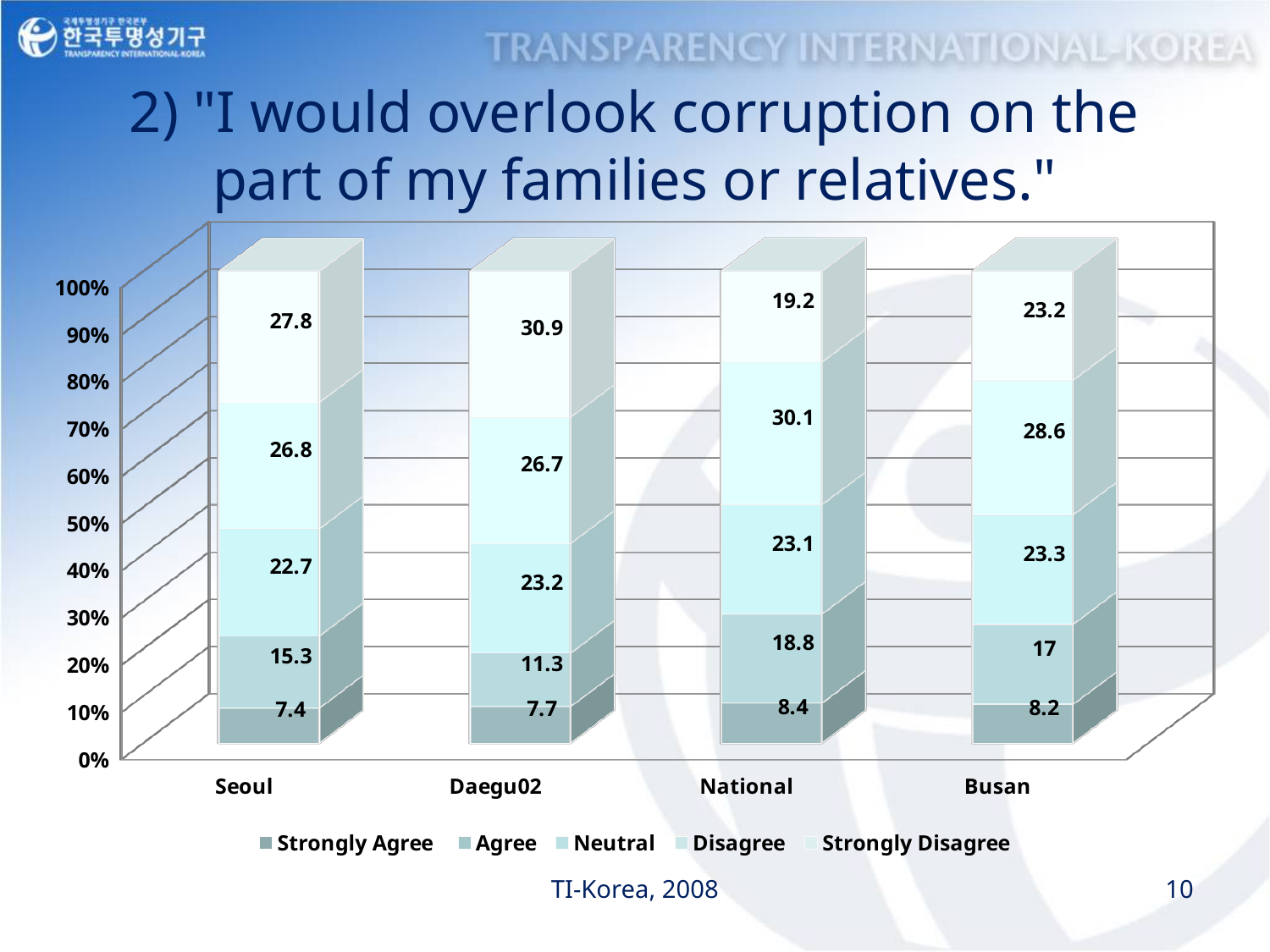
Which is larger, the Strongly Disagree value for Seoul or for Busan? Seoul What is the Agree value for National? 18.8 Which legend entry is listed first? Strongly Agree What is the Neutral value for Busan? 23.3 How many series does the legend list? 5 What is the Strongly Disagree value for Daegu02? 30.9 What is the Strongly Agree value for Seoul? 7.4 How many categories are shown on the x axis? 4 Which category has the lowest Agree value? Daegu02 Which category has the highest Strongly Disagree value? Daegu02 What is the difference between the Disagree values for National and Seoul? 3.3 What kind of chart is shown on the slide? Stacked bar chart